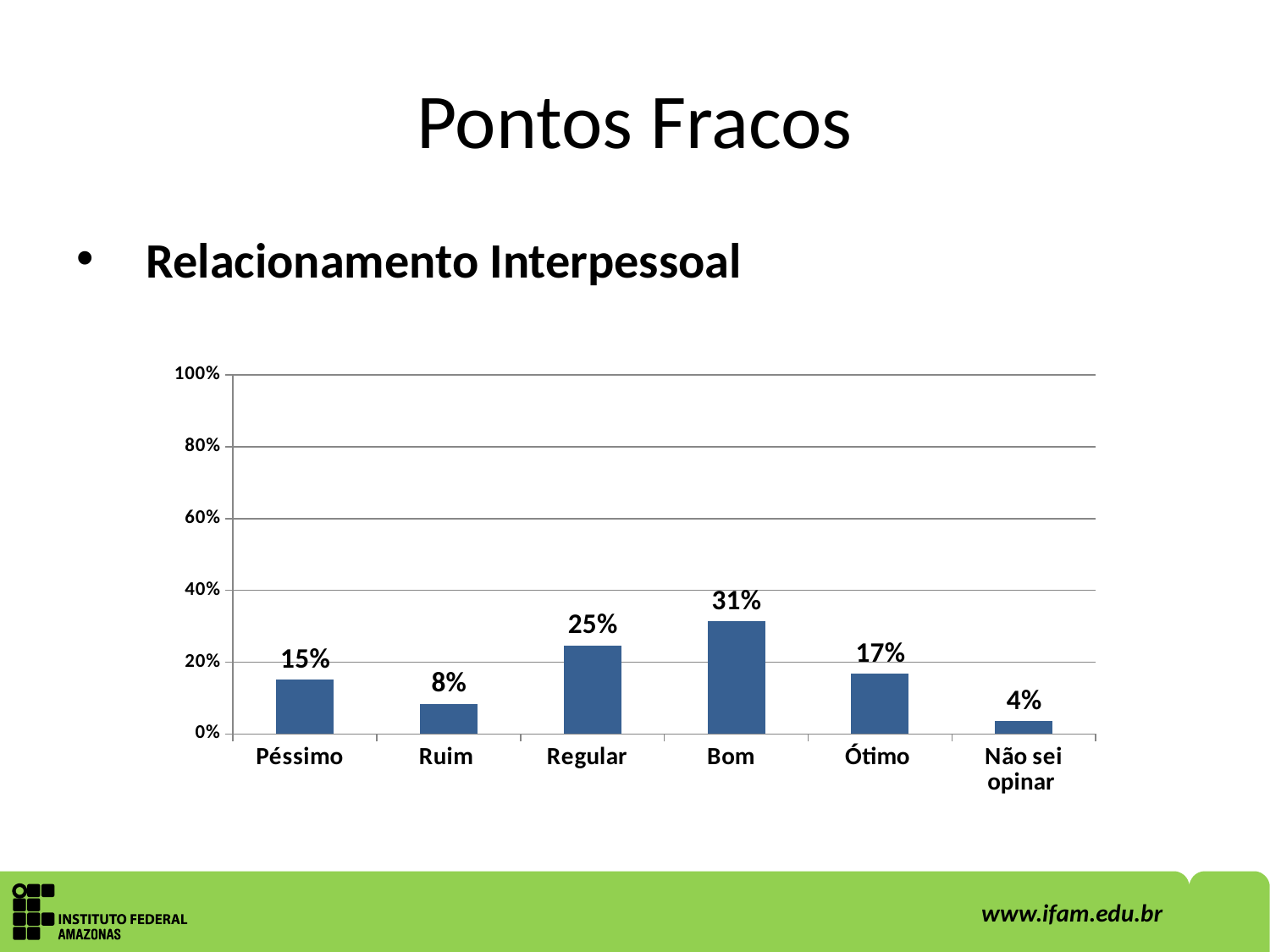
Which is larger, the value for Péssimo or the value for Ótimo? Ótimo What is the value for Não sei opinar? 4% What is the difference between the values for Bom and Regular? 6% What is the value for Bom? 31% How many categories are shown on the x axis? 6 What kind of chart is shown on the slide? bar chart What is the difference between the values for Ótimo and Ruim? 9% What is the topic listed in the bullet point above the chart? Relacionamento Interpessoal Which category has the lowest value? Não sei opinar What is the value for Regular? 25% Which category has the highest value? Bom Is the value for Regular greater or less than 20%? greater